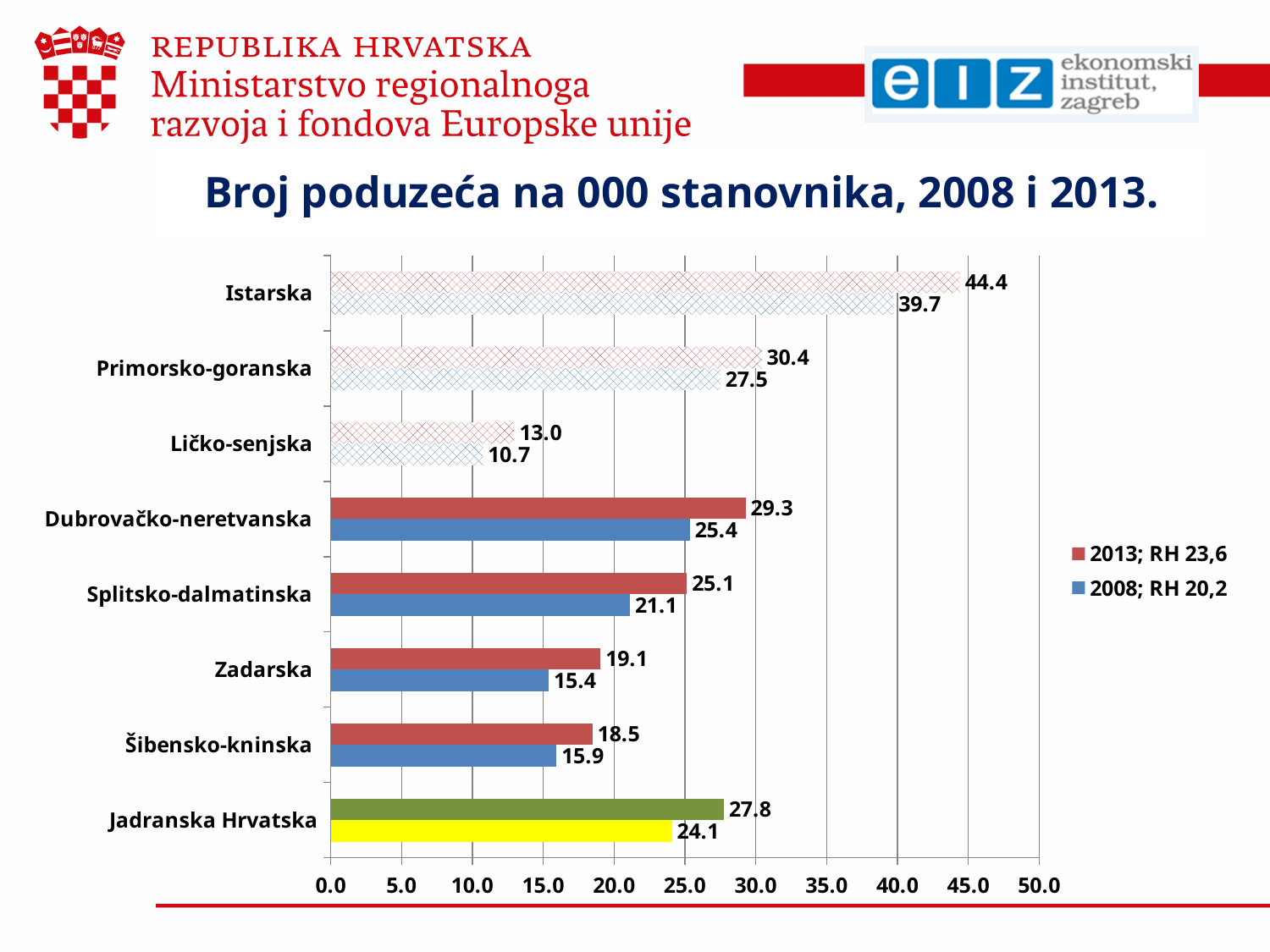
What is the 2013 value for Jadranska Hrvatska? 27.8 Which category has the lowest 2008 value? Ličko-senjska What is the difference between the 2013 values for Istarska and Primorsko-goranska? 14.0 What is the title of the chart? Broj poduzeća na 000 stanovnika, 2008 i 2013. How many categories are shown on the chart? 8 What is the difference between the 2013 and 2008 values for Dubrovačko-neretvanska? 3.9 Which category has the highest 2013 value? Istarska Which is larger, the 2013 value for Zadarska or the 2013 value for Šibensko-kninska? Zadarska What is the 2008 value for Ličko-senjska? 10.7 What kind of chart is shown on the slide? Bar chart What is the 2013 value for Istarska? 44.4 How many series does the legend list? 2